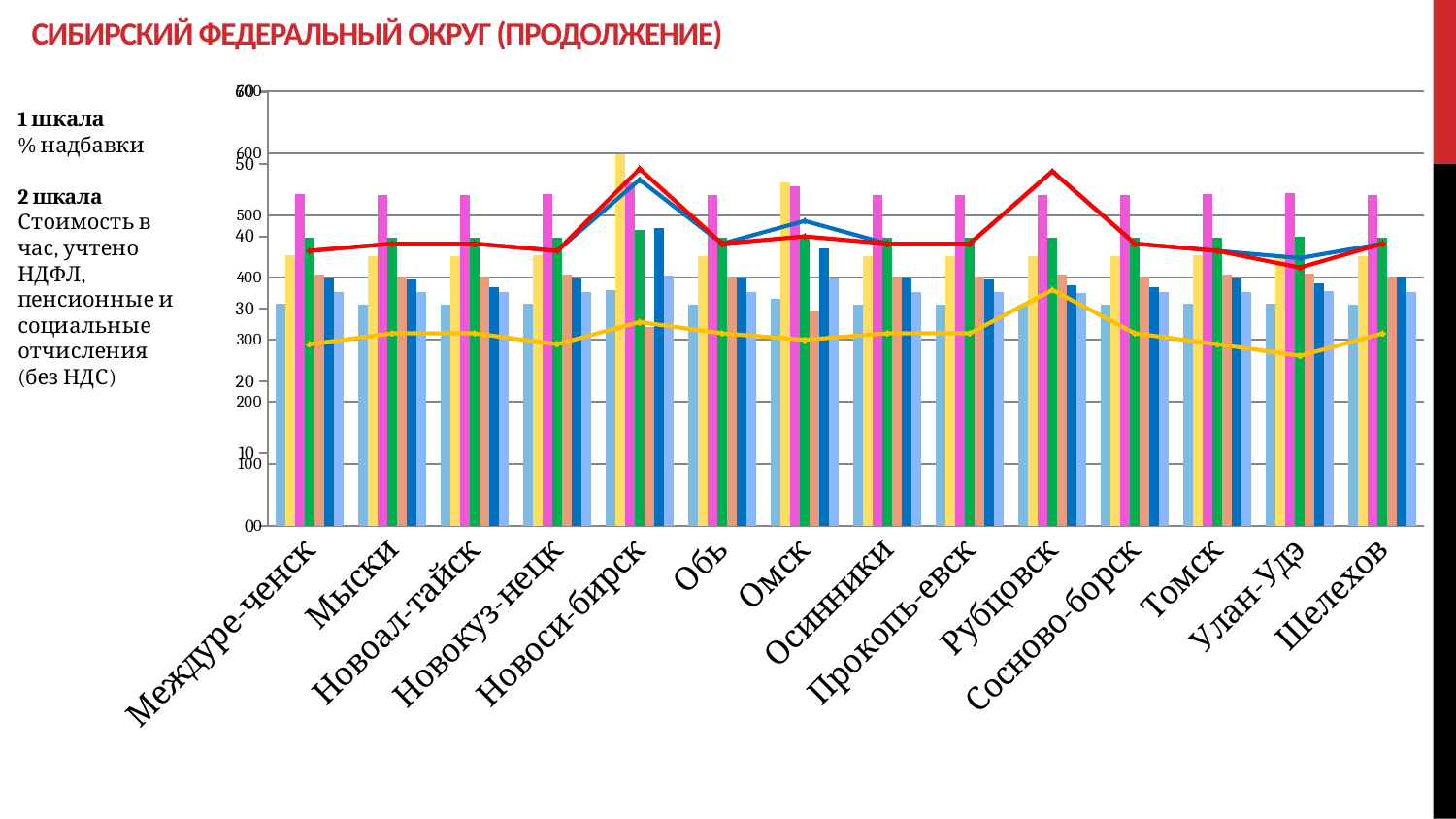
What is the title of the slide containing the chart? СИБИРСКИЙ ФЕДЕРАЛЬНЫЙ ОКРУГ (ПРОДОЛЖЕНИЕ) What kind of chart is shown on the slide? A combined bar and line chart For which city does the yellow bar reach its highest value? Новосибирск Which is the first city listed on the x axis of the chart? Междуреченск Which is the last city listed on the x axis of the chart? Шелехов For which city does the yellow line reach its lowest point? Улан-Удэ Which city has the taller yellow bar, Новосибирск or Омск? Новосибирск What colours are the three lines plotted on the chart? Red, blue and yellow For which city does the yellow line reach its highest point? Рубцовск How many cities (categories) are shown along the x axis of the chart? 14 How many lines are plotted over the bars in the chart? 3